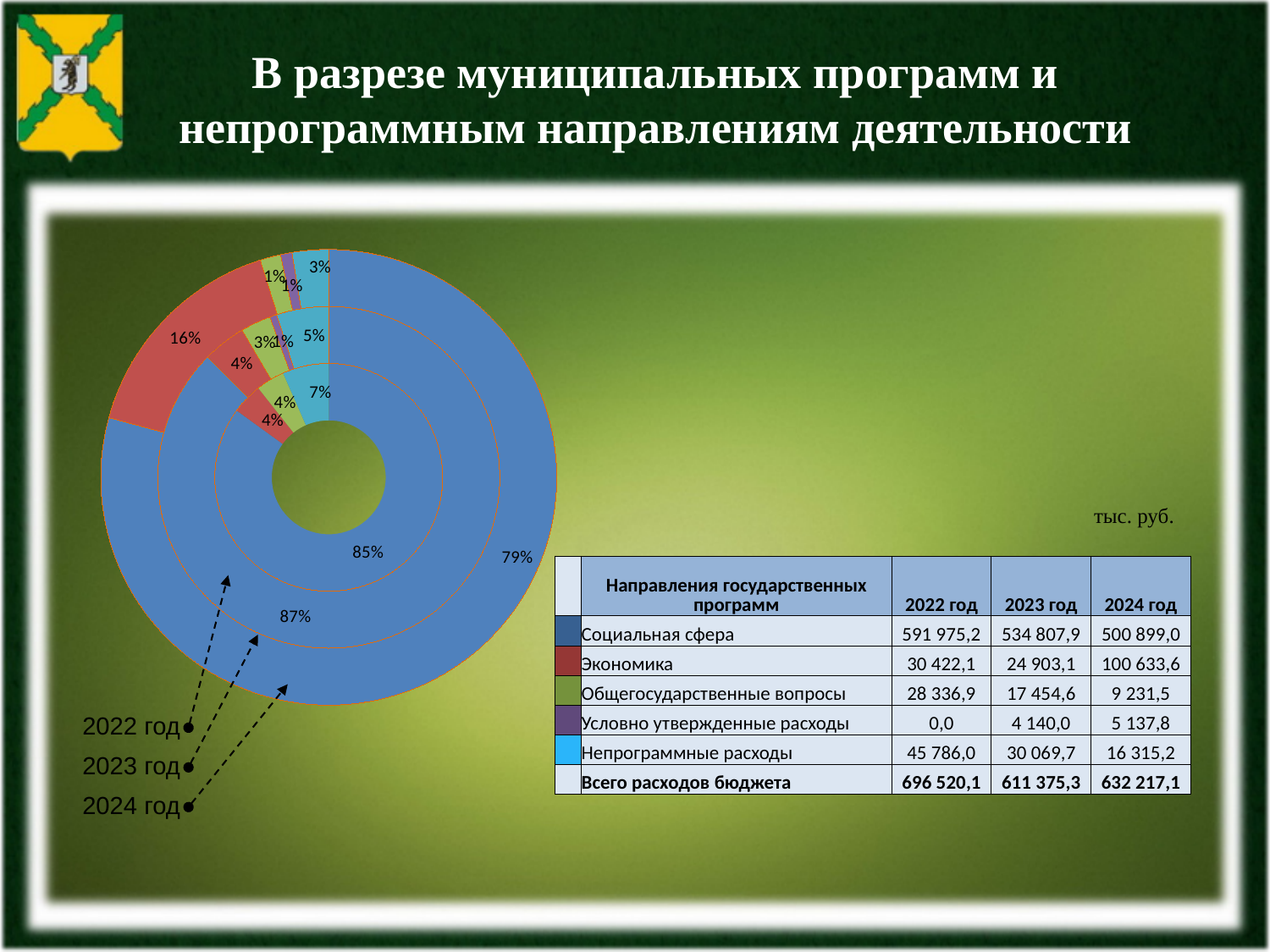
What share of the 2022 ring (inner ring) is Непрограммные расходы? 7% How many rings (years) does the doughnut chart have? 3 Which category has the largest share in every ring of the doughnut chart? Социальная сфера What share of the 2022 ring (inner ring) is Социальная сфера? 85% What colour represents Социальная сфера in the doughnut chart? blue What share of the 2024 ring (outer ring) is Экономика? 16% What kind of chart is shown on the slide? doughnut chart In the 2024 ring, which is larger: the share of Экономика or the share of Непрограммные расходы? Экономика Which year's ring is the outermost ring of the doughnut chart? 2024 год By how many percentage points does the share of Социальная сфера in the 2023 ring exceed its share in the 2024 ring? 8